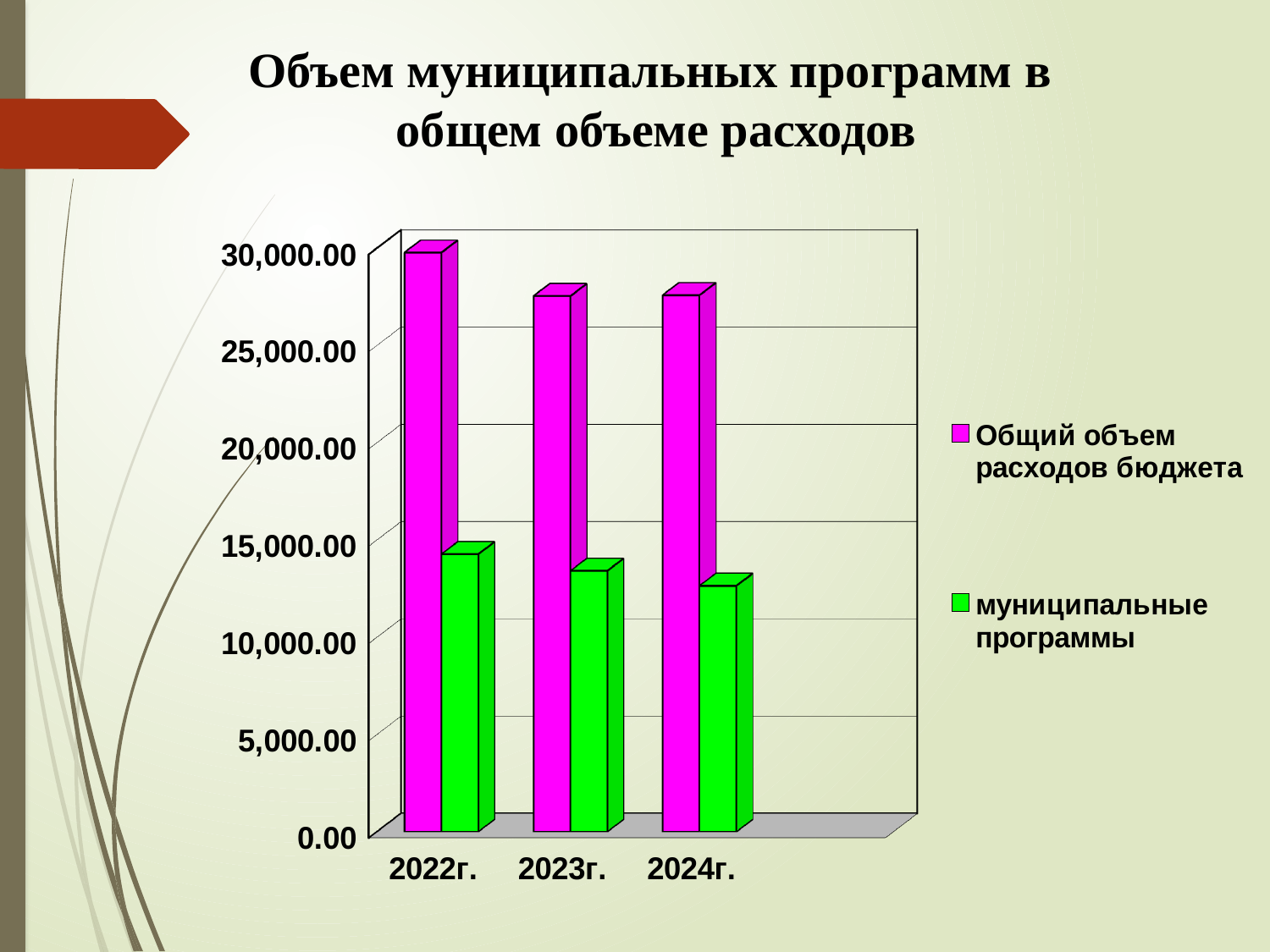
In which year is the value for 'муниципальные программы' lowest? 2024г. What kind of chart is shown on the slide? bar chart Is the value for 'Общий объем расходов бюджета' in 2023г. greater or less than 30,000.00? less In which year is the value for 'муниципальные программы' highest? 2022г. Is the value for 'Общий объем расходов бюджета' in 2022г. greater or less than 25,000.00? greater How many series does the legend list? 2 Do the values for 'муниципальные программы' rise or fall from 2022г. to 2024г.? fall Is the value for 'муниципальные программы' in 2024г. greater or less than 15,000.00? less Which colour represents the series 'муниципальные программы'? green What is the title of the chart? Объем муниципальных программ в общем объеме расходов In which year is the value for 'Общий объем расходов бюджета' highest? 2022г. How many years are shown on the x axis? 3